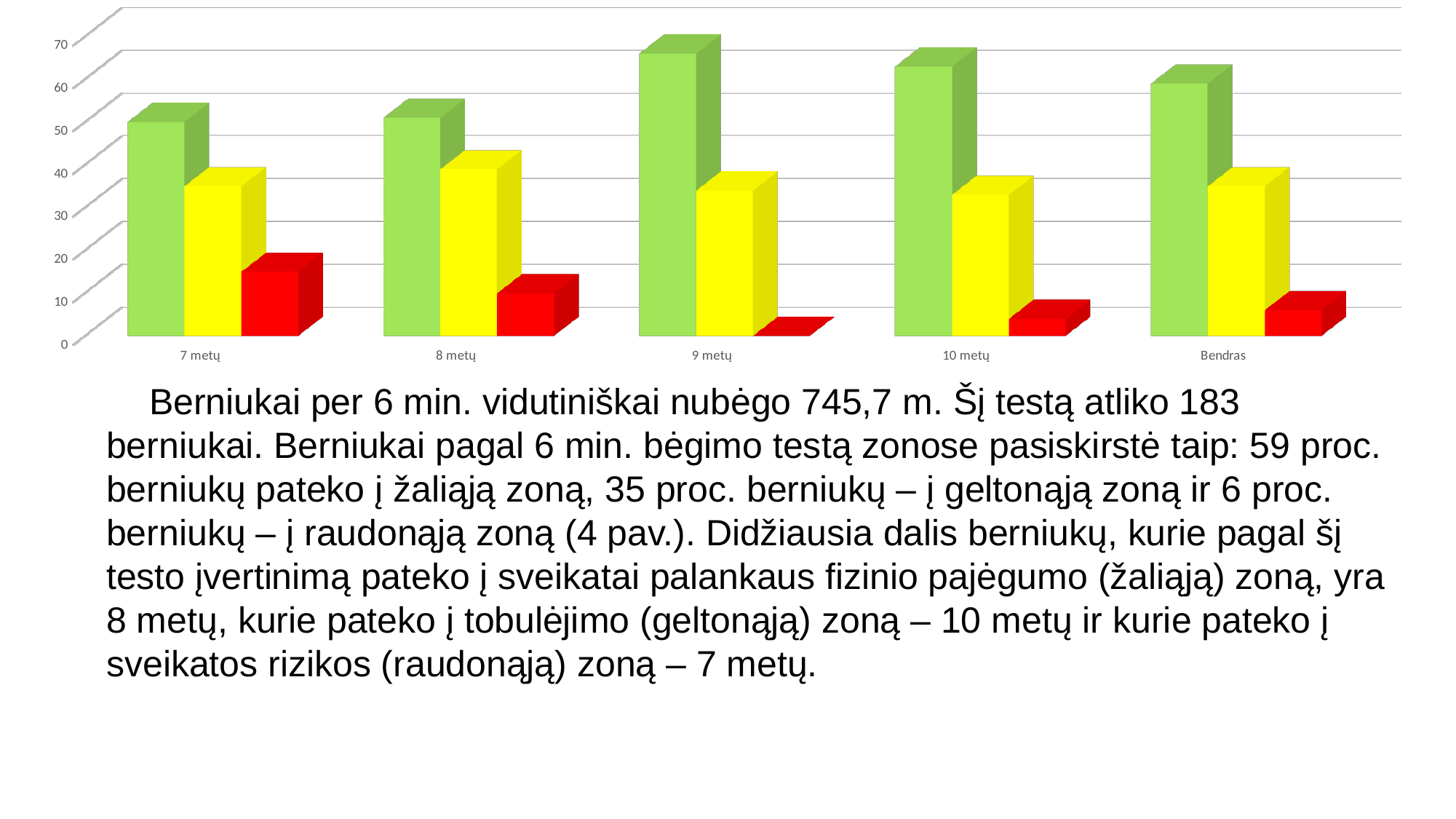
Which category has the tallest red bar? 7 metų Which category has the tallest green bar? 9 metų Which category has the shortest red bar? 9 metų Which is larger, the green bar for 9 metų or the green bar for 7 metų? 9 metų Is the green bar for 9 metų greater or less than 60? greater Is the green bar for Bendras greater or less than 50? greater Is the yellow bar for 9 metų greater or less than 40? less How many categories are shown on the x axis of the chart? 5 What colours are the three bars in each category group? green, yellow and red What kind of chart is shown on the slide? bar chart